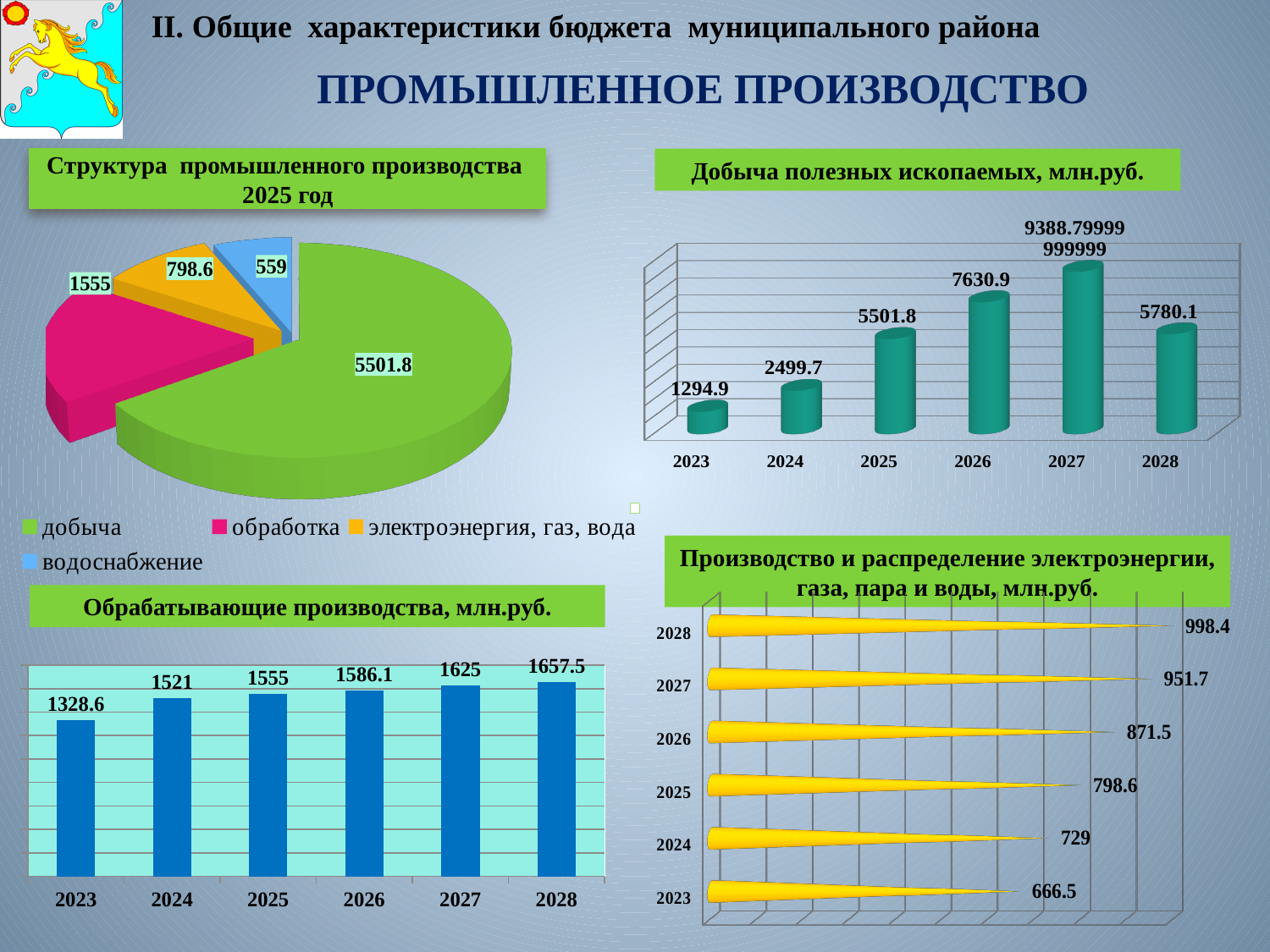
In the pie chart 'Структура промышленного производства 2025 год', what is the difference between обработка and электроэнергия, газ, вода? 756.4 In the chart 'Добыча полезных ископаемых, млн.руб.', what is the value for 2026? 7630.9 In the chart 'Добыча полезных ископаемых, млн.руб.', which year has the highest value? 2027 In the pie chart 'Структура промышленного производства 2025 год', which category has the smallest slice? водоснабжение In the chart 'Производство и распределение электроэнергии, газа, пара и воды, млн.руб.', which is larger: 2024 or 2026? 2026 In the chart 'Обрабатывающие производства, млн.руб.', do the values rise or fall from 2023 to 2028? rise In the chart 'Обрабатывающие производства, млн.руб.', what is the value for 2028? 1657.5 In the chart 'Добыча полезных ископаемых, млн.руб.', what is the difference between 2025 and 2024? 3002.1 What kind of chart is 'Обрабатывающие производства, млн.руб.'? bar chart In the chart 'Добыча полезных ископаемых, млн.руб.', which year has the lowest value? 2023 In the pie chart 'Структура промышленного производства 2025 год', what is the value for добыча? 5501.8 How many categories does the legend of the pie chart 'Структура промышленного производства 2025 год' list? 4